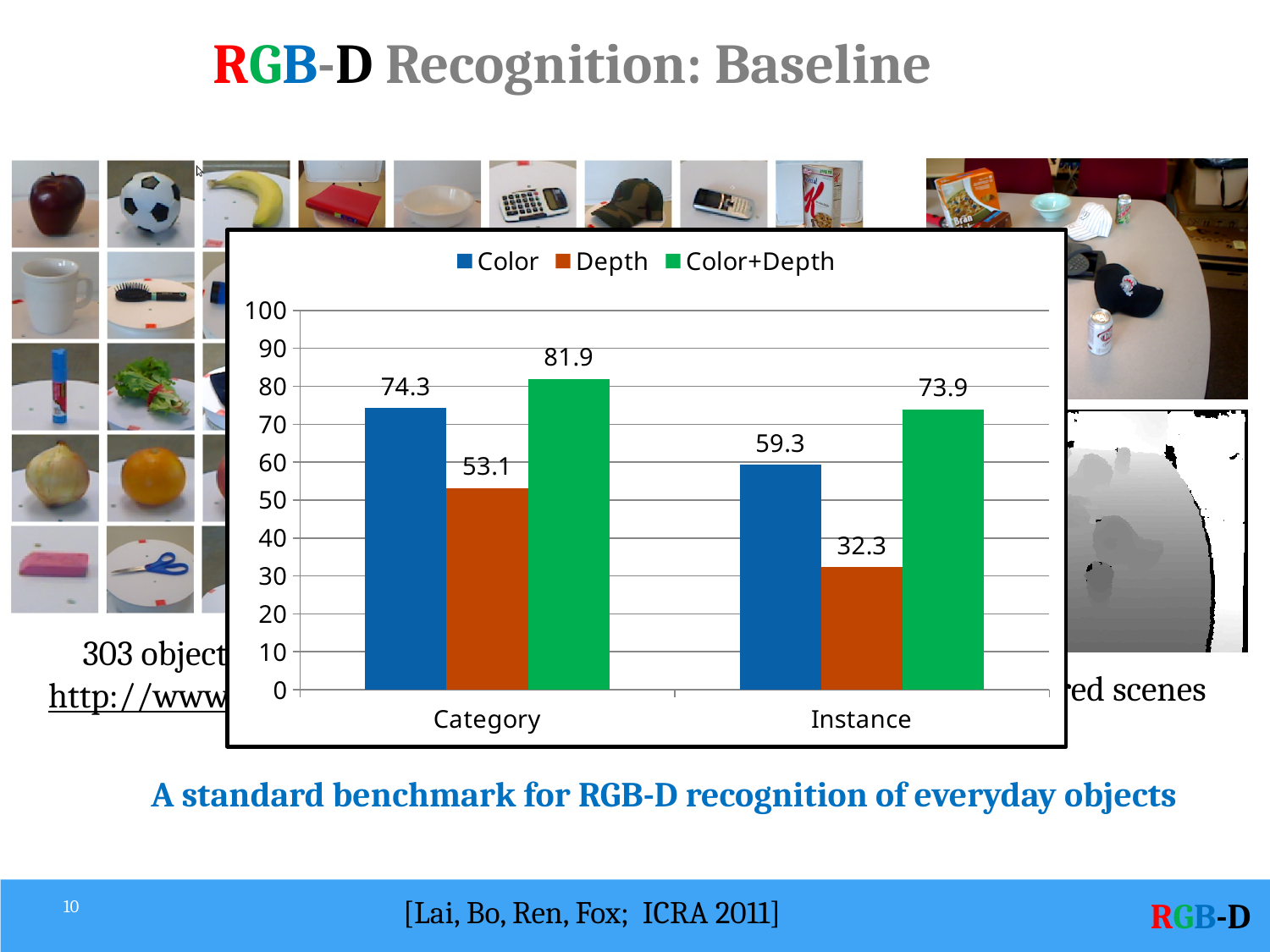
Which series has the lowest value in the Category group? Depth What is the value for Depth in the Instance group? 32.3 How many categories are shown on the x axis? 2 What colour represents the Depth series? orange What is the difference between Color+Depth and Color in the Category group? 7.6 What is the value for Color+Depth in the Category group? 81.9 Which series has the highest value in the Instance group? Color+Depth What kind of chart is shown? bar chart How many series does the legend list? 3 What is the difference between Color and Depth in the Instance group? 27 Which is larger: Color for Category or Color+Depth for Instance? Color for Category What is the value for Color in the Category group? 74.3